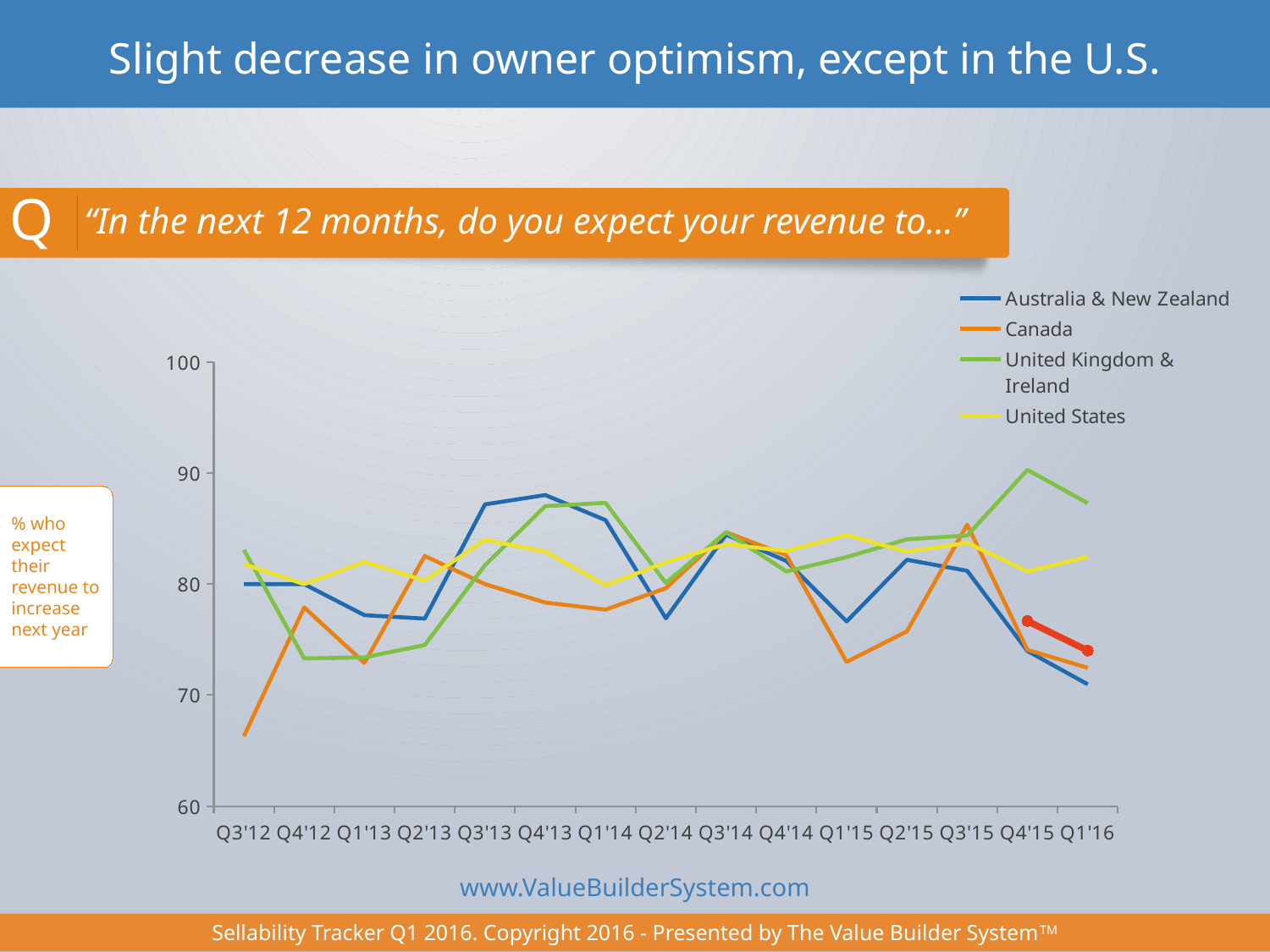
At Q3'13, which is higher: Australia & New Zealand or Canada? Australia & New Zealand Does the Australia & New Zealand line rise or fall from Q2'15 to Q1'16? fall What kind of chart is shown on the slide? line chart How many quarters are shown along the x axis? 15 Which series is drawn in yellow? United States How many series does the legend list? 4 Is the value for Canada at Q3'12 greater or less than 70? less Which series has the highest value at Q1'16? United Kingdom & Ireland Is the value for United Kingdom & Ireland at Q4'15 greater or less than 80? greater What is the first quarter shown on the x axis? Q3'12 Is the value for Australia & New Zealand at Q1'16 greater or less than 80? less Which series has the lowest value at Q3'12? Canada